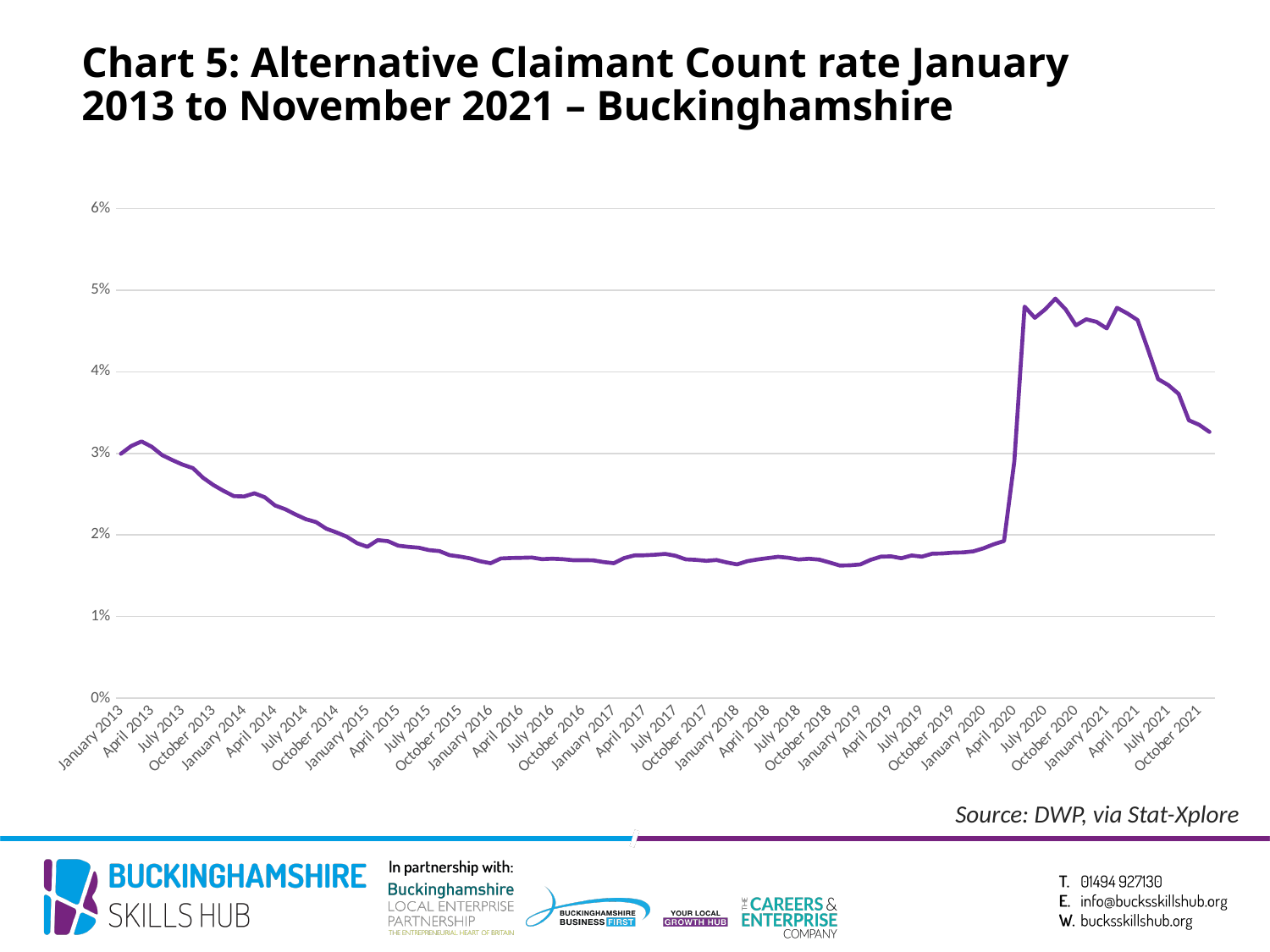
Is the value for July 2020 greater or less than 4%? greater Which is larger, the value for July 2020 or the value for January 2020? July 2020 Is the value for January 2016 greater or less than 2%? less Is the value for October 2013 greater or less than 3%? less Does the claimant count rate rise or fall between January 2020 and July 2020? rise Which is larger, the value for October 2021 or the value for October 2013? October 2021 What kind of chart is shown on the slide? line chart What source is cited for the chart? DWP, via Stat-Xplore Does the claimant count rate rise or fall between January 2013 and January 2016? fall What is the title of the chart? Chart 5: Alternative Claimant Count rate January 2013 to November 2021 – Buckinghamshire